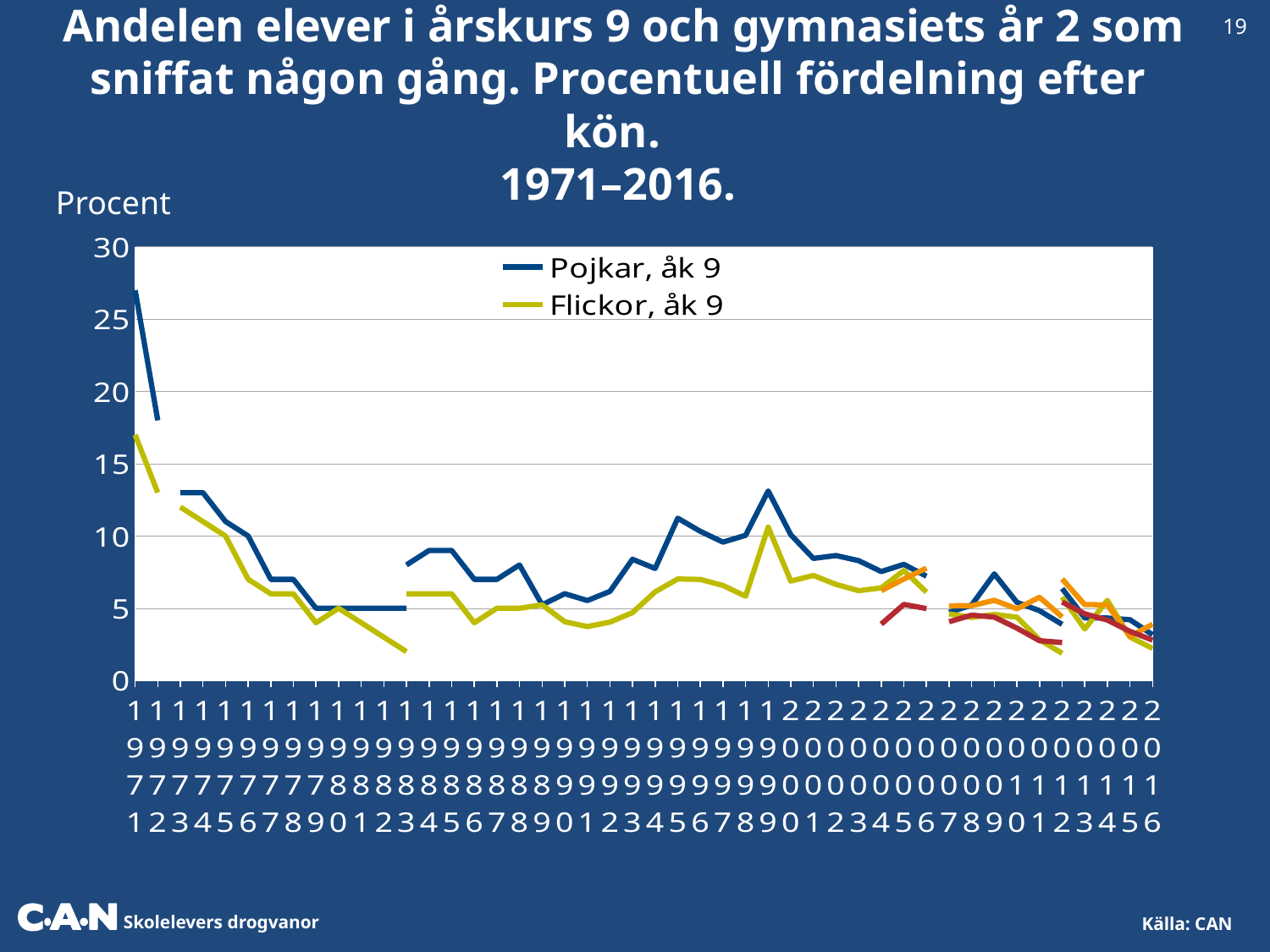
In 1999, which series has the higher value, Pojkar, åk 9 or Flickor, åk 9? Pojkar, åk 9 Is the value for Pojkar, åk 9 in 1999 greater or less than 10? greater What kind of chart is shown on the slide? Line chart Does the Pojkar, åk 9 line rise or fall between 1971 and 1980? Fall Is the value for Pojkar, åk 9 in 2016 greater or less than 5? less What are the two series named in the chart legend? Pojkar, åk 9 and Flickor, åk 9 What is the label shown above the vertical axis of the chart? Procent How many series does the chart legend list? 2 Is the value for Pojkar, åk 9 in 1971 greater or less than 25? greater In 1971, which series has the higher value, Pojkar, åk 9 or Flickor, åk 9? Pojkar, åk 9